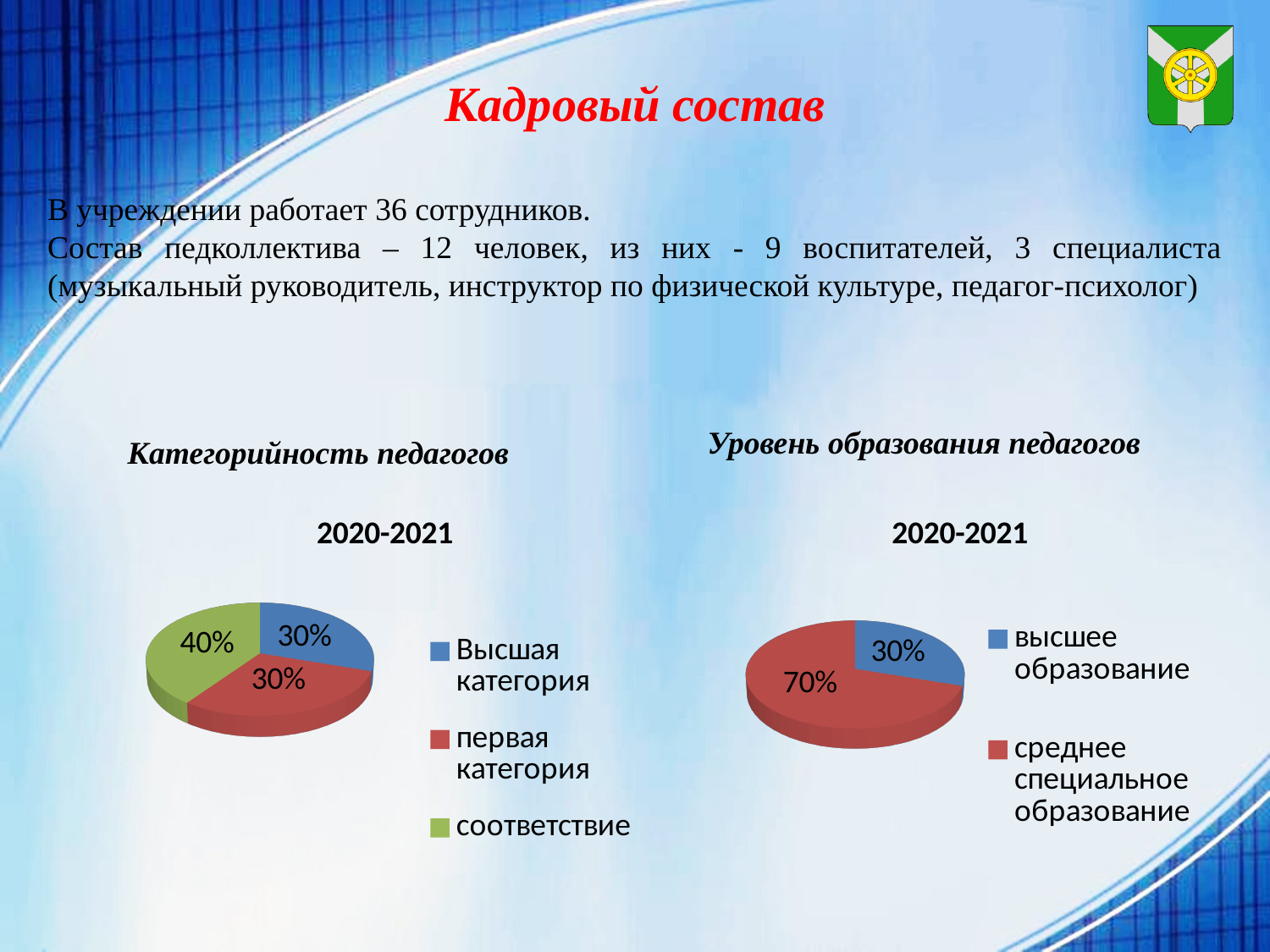
How many entries does the legend of the chart 'Уровень образования педагогов' list? 2 In the chart 'Уровень образования педагогов', which category has the smallest share? высшее образование What kind of chart is used for 'Категорийность педагогов'? Pie chart In the chart 'Категорийность педагогов', what share of the pie is 'Высшая категория'? 30% In the chart 'Уровень образования педагогов', what share of the pie is 'среднее специальное образование'? 70% In the chart 'Категорийность педагогов', what colour is the slice for 'первая категория'? Red In the chart 'Категорийность педагогов', which category has the largest share? соответствие In the chart 'Категорийность педагогов', how many slices does the pie have? 3 In the chart 'Уровень образования педагогов', what share of the pie is 'высшее образование'? 30% In the chart 'Категорийность педагогов', what is the difference between the share of 'соответствие' and the share of 'первая категория'? 10% In the chart 'Категорийность педагогов', what share of the pie is 'соответствие'? 40% In the chart 'Уровень образования педагогов', what is the difference between the shares of 'среднее специальное образование' and 'высшее образование'? 40%